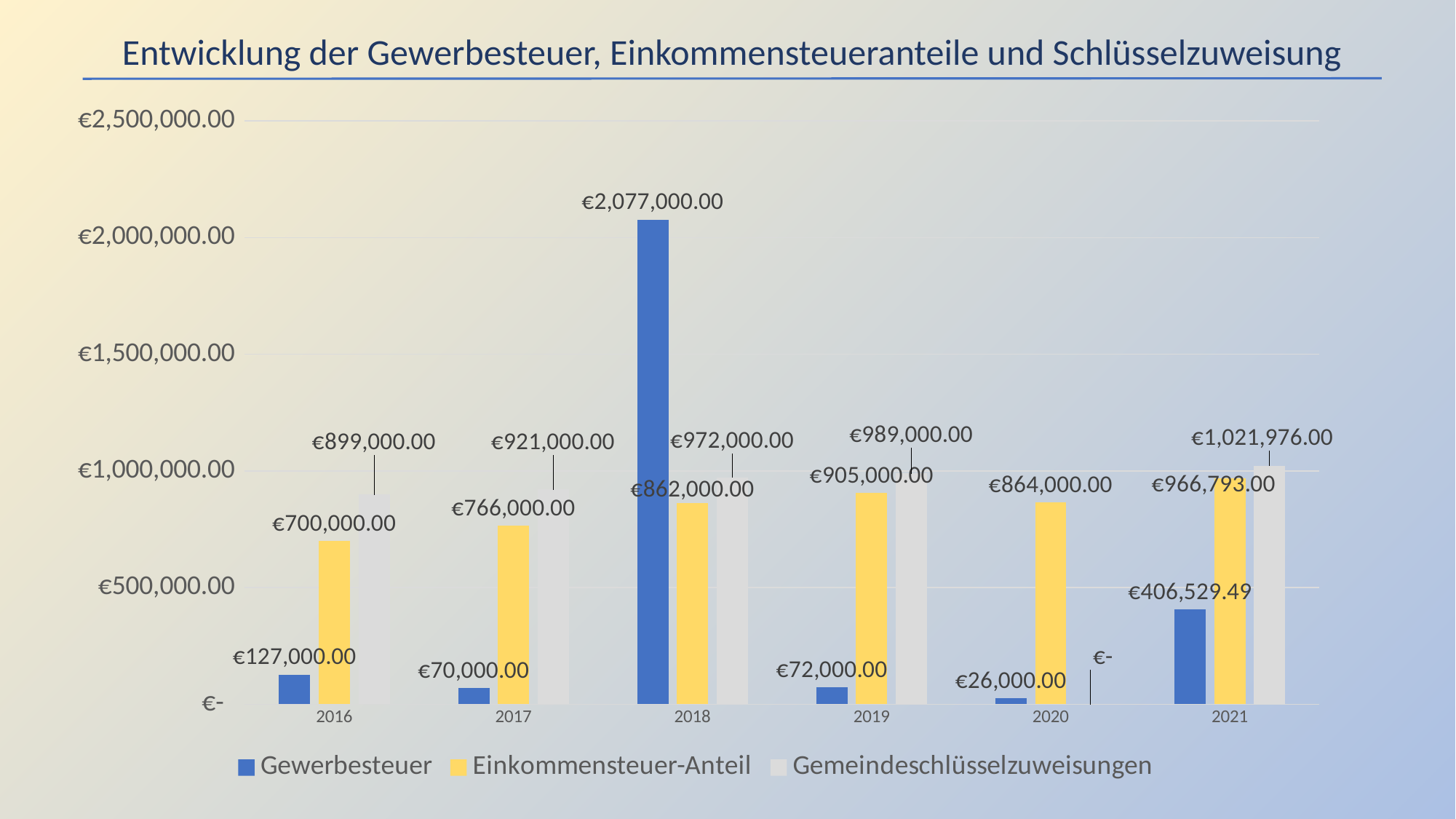
What is the Gewerbesteuer value for 2021? €406,529.49 In which year is the Gewerbesteuer value the highest? 2018 What is the difference between the Gemeindeschlüsselzuweisungen value in 2019 and in 2016? €90,000.00 What is the Einkommensteuer-Anteil value for 2019? €905,000.00 What is the Gemeindeschlüsselzuweisungen value for 2021? €1,021,976.00 What is the Gewerbesteuer value for 2018? €2,077,000.00 Which is larger in 2017: the Einkommensteuer-Anteil or the Gemeindeschlüsselzuweisungen? Gemeindeschlüsselzuweisungen How many years are shown on the x axis? 6 How many series does the legend list? 3 In which year is the Gewerbesteuer value the lowest? 2020 Does the Einkommensteuer-Anteil rise or fall from 2016 to 2019? Rise What kind of chart is shown on the slide? Bar chart